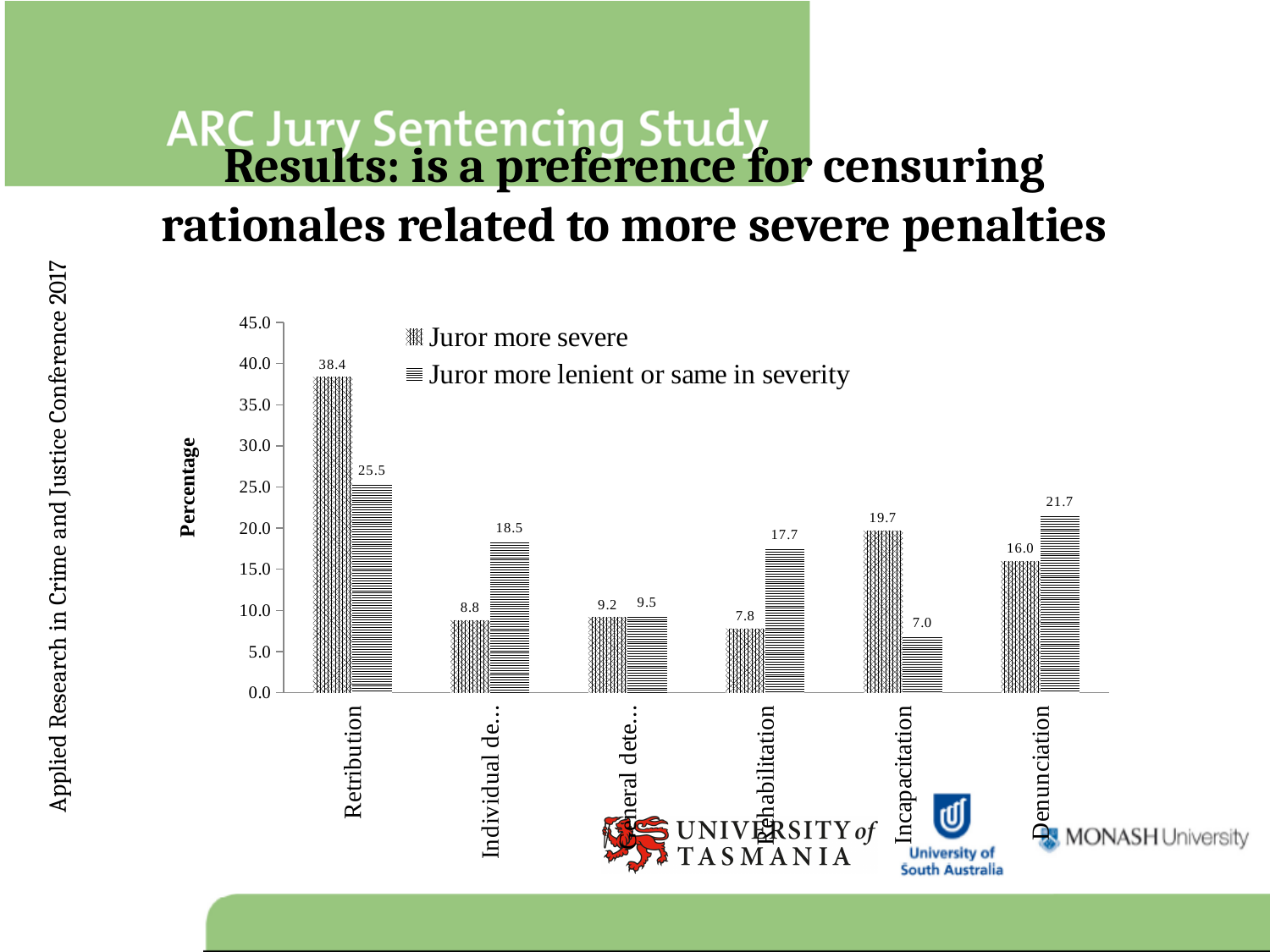
What is the difference between the 'Juror more lenient or same in severity' and 'Juror more severe' values for Rehabilitation? 9.9 Which category has the highest value in the 'Juror more severe' series? Retribution What is the value for Denunciation in the 'Juror more severe' series? 16.0 For Denunciation, which series has the larger value: 'Juror more severe' or 'Juror more lenient or same in severity'? Juror more lenient or same in severity How many series does the legend list? 2 What is the difference between the 'Juror more severe' and 'Juror more lenient or same in severity' values for Retribution? 12.9 Which category has the lowest value in the 'Juror more lenient or same in severity' series? Incapacitation What is the label on the vertical axis of the chart? Percentage What is the value for Retribution in the 'Juror more severe' series? 38.4 What is the value for Incapacitation in the 'Juror more lenient or same in severity' series? 7.0 What is the value for Retribution in the 'Juror more lenient or same in severity' series? 25.5 What kind of chart is shown on the slide? Bar chart